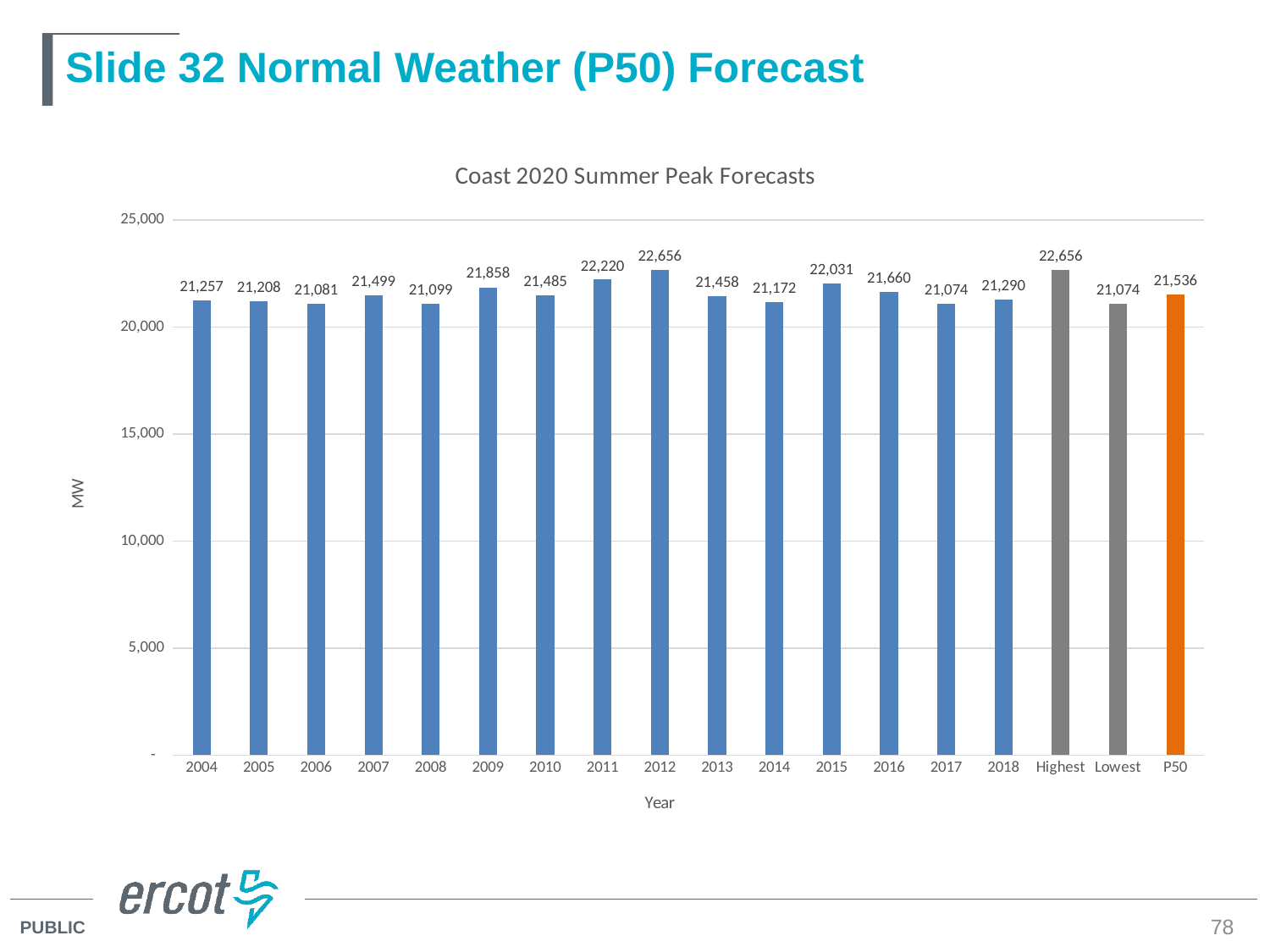
How many bars are plotted in the chart? 18 What is the P50 value shown in the chart? 21,536 Which is larger, the value for 2011 or the value for 2015? 2011 Is the value for 2007 greater or less than 20,000? greater Which year has the highest forecast value? 2012 Which year has the lowest forecast value? 2017 What is the value for 2009? 21,858 What is the difference between the Highest and Lowest bars? 1,582 What is the title of the chart? Coast 2020 Summer Peak Forecasts What is the value for 2012 in the Coast 2020 Summer Peak Forecasts chart? 22,656 What is the label on the y axis? MW What kind of chart is shown on the slide? bar chart